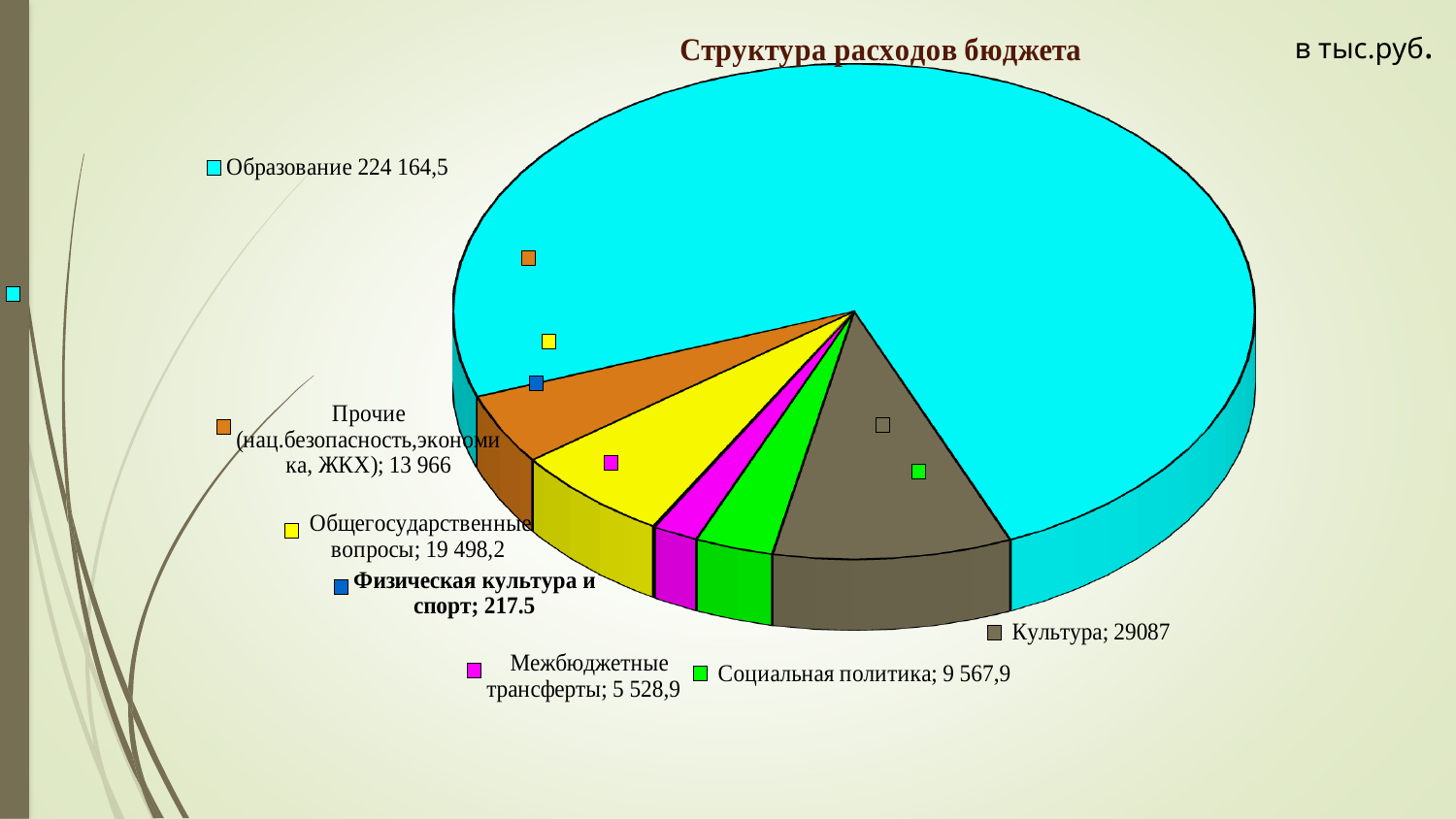
What is the value for Социальная политика? 9 567,9 Which category has the largest slice of the pie? Образование What is the value for Культура? 29087 Which is larger: Общегосударственные вопросы or Прочие (нац.безопасность, экономика, ЖКХ)? Общегосударственные вопросы What is the title of the chart? Структура расходов бюджета What is the value for Образование? 224 164,5 What is the difference between Социальная политика and Межбюджетные трансферты? 4 039 Which category has the smallest value? Физическая культура и спорт What kind of chart is shown on the slide? Pie chart How many categories does the pie chart show? 7 What is the value for Физическая культура и спорт? 217.5 What is the difference between Культура and Общегосударственные вопросы? 9 588,8